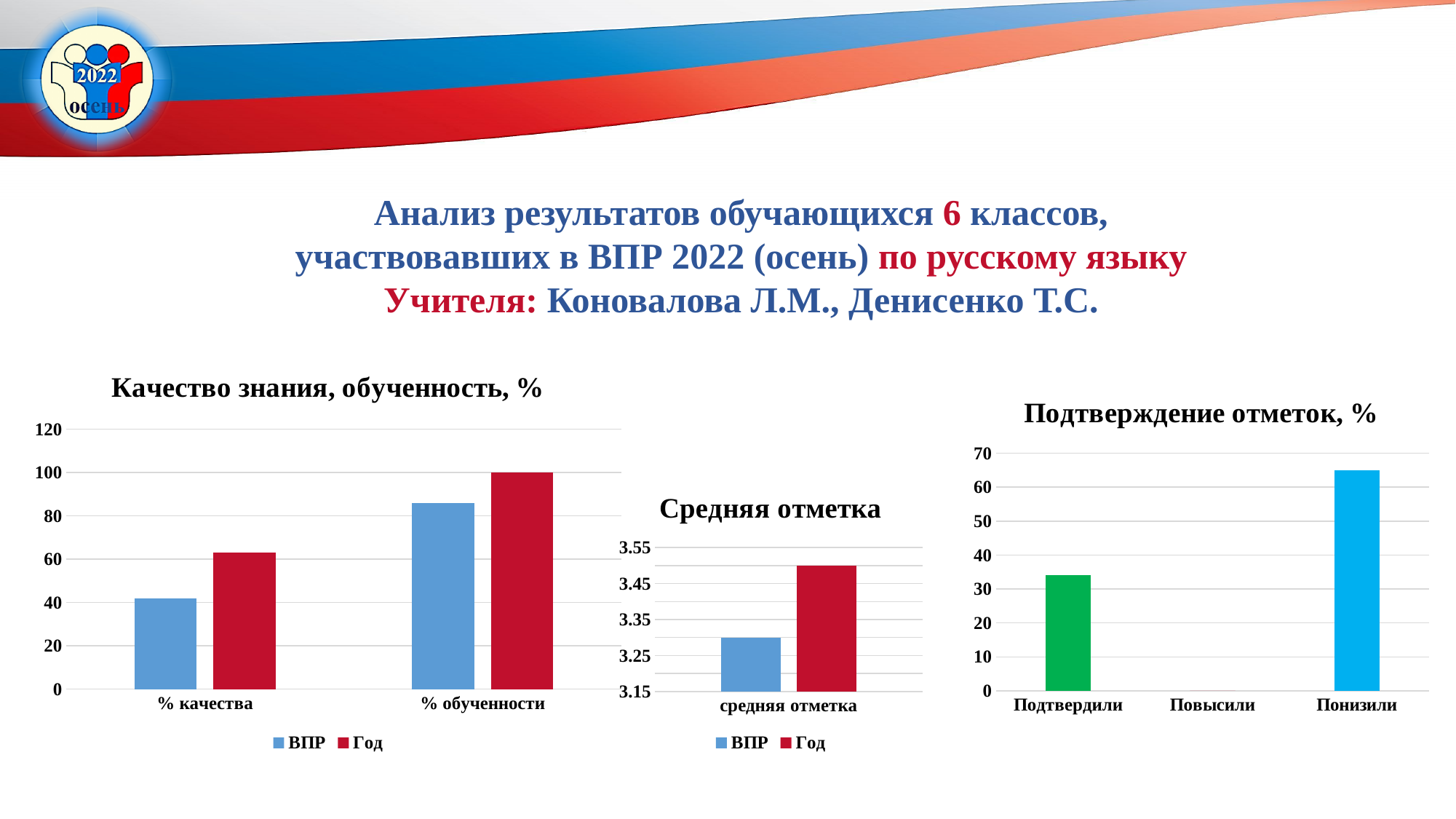
In the chart "Подтверждение отметок, %", which category has the lowest value? Повысили In the chart "Подтверждение отметок, %", how many categories are shown on the x axis? 3 In the chart "Подтверждение отметок, %", which category has the highest value? Понизили In the chart "Качество знания, обученность, %", is the value of ВПР for % обученности greater or less than 80? greater In the chart "Качество знания, обученность, %", which is larger for % качества: ВПР or Год? Год What kind of chart is "Качество знания, обученность, %"? bar chart In the chart "Средняя отметка", is the value of ВПР greater or less than 3.35? less In the chart "Качество знания, обученность, %", how many series does the legend list? 2 In the chart "Качество знания, обученность, %", what is the value of Год for % обученности? 100 In the chart "Подтверждение отметок, %", is the value for Подтвердили greater or less than 30? greater In the chart "Средняя отметка", which series has the higher value: ВПР or Год? Год